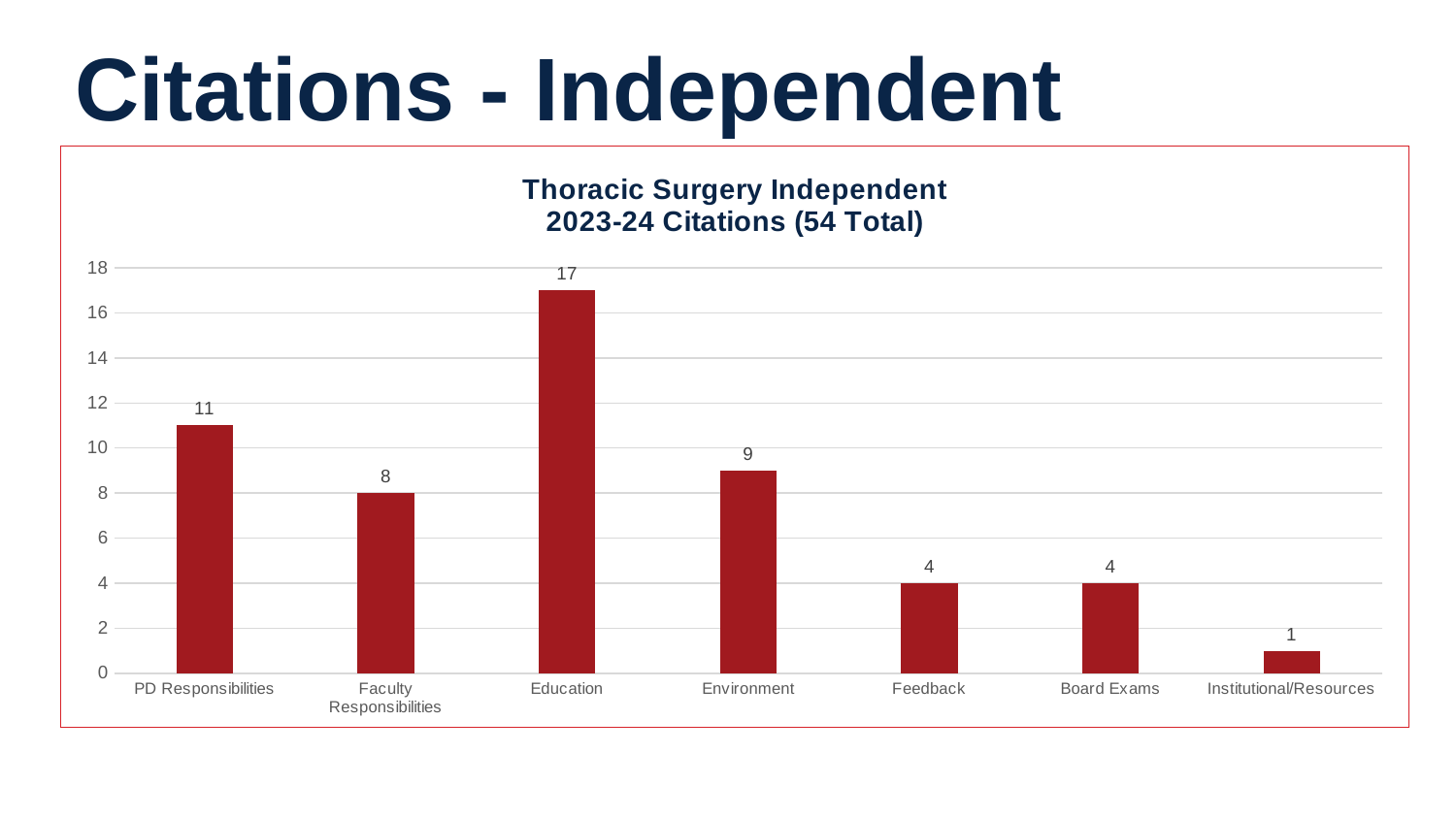
Which category has the lowest number of citations? Institutional/Resources Which is larger, the value for Environment or the value for Faculty Responsibilities? Environment What is the value for PD Responsibilities? 11 What is the difference between the values for Feedback and Institutional/Resources? 3 How many citations are shown for Education? 17 What is the title of the chart? Thoracic Surgery Independent 2023-24 Citations (54 Total) What is the difference between the values for Education and PD Responsibilities? 6 Is the value for Environment greater or less than 10? less What is the value for Institutional/Resources? 1 How many categories are shown on the x axis? 7 What kind of chart is this? bar chart Which category has the highest number of citations? Education